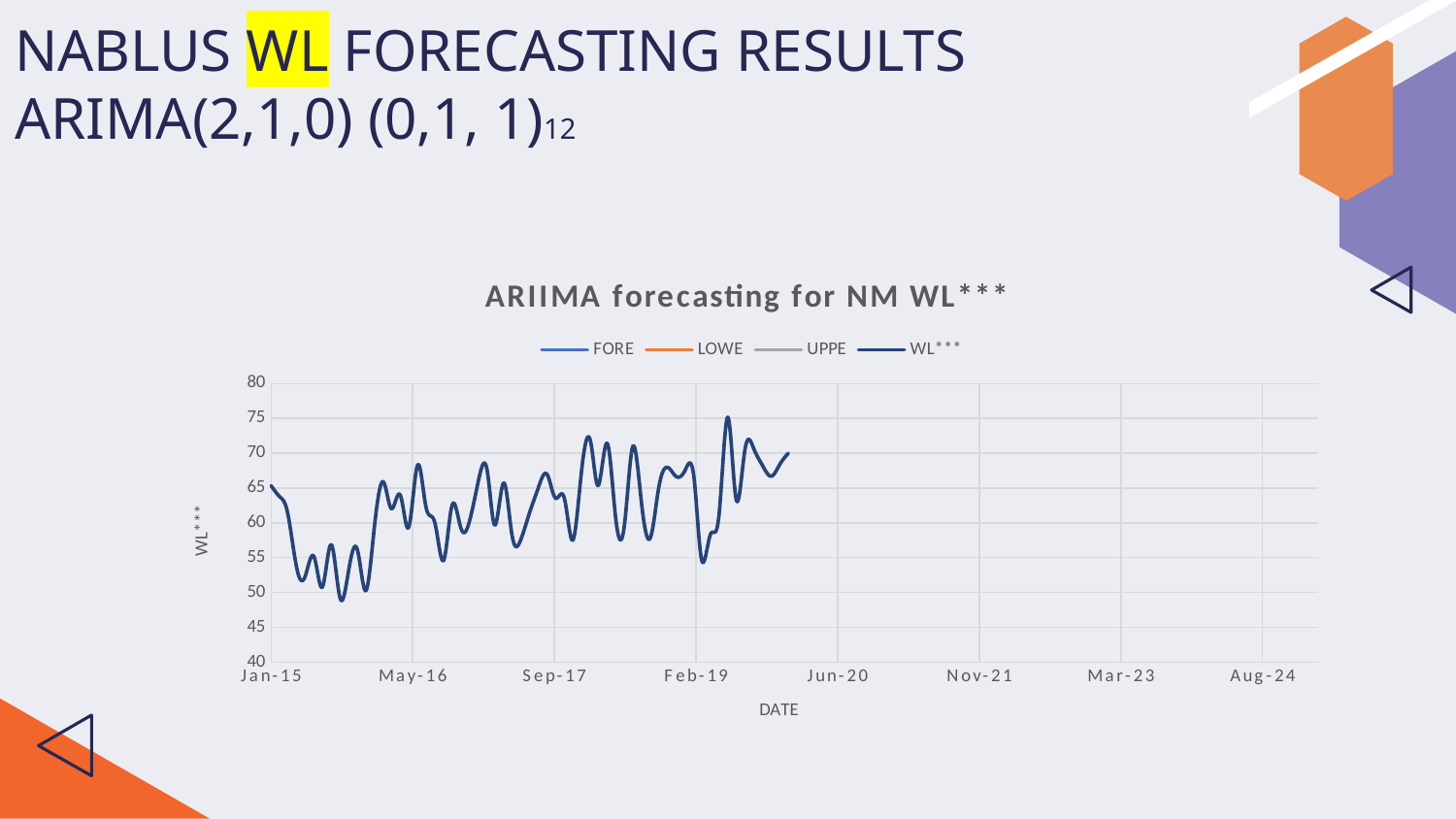
How many date labels are shown along the x axis of the chart? 8 How many series does the legend of the chart list? 4 Is the highest point of the WL*** series greater or less than 70? greater Is the value of the WL*** series at its last plotted point (around early 2020) greater or less than 65? greater Is the value of the WL*** series at Jan-15 greater or less than 60? greater Does the WL*** series extend beyond the Jun-20 tick on the x axis? No What are the four series names listed in the chart legend? FORE, LOWE, UPPE, WL*** What kind of chart is shown on the slide? line chart What is the title of the chart? ARIIMA forecasting for NM WL***